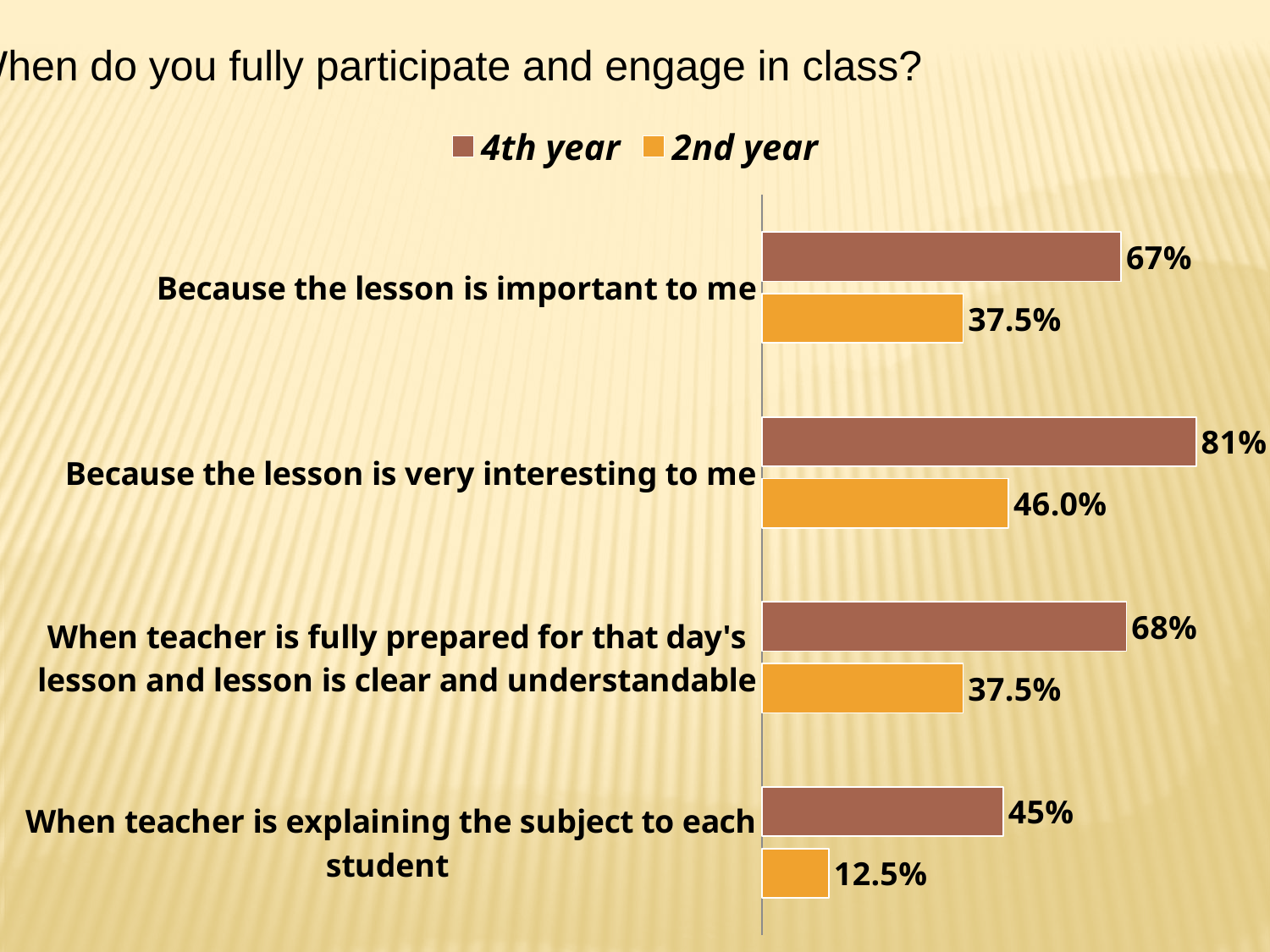
What is the 2nd year value for "When teacher is explaining the subject to each student"? 12.5% Which series is shown in orange in the legend? 2nd year How many series does the legend list? 2 What kind of chart is shown on the slide? Bar chart Which category has the lowest 2nd year value? When teacher is explaining the subject to each student What is the difference between the 4th year and 2nd year values for "Because the lesson is very interesting to me"? 35 percentage points How many categories are shown in the chart? 4 What is the 4th year value for "When teacher is fully prepared for that day's lesson and lesson is clear and understandable"? 68% Which category has the highest 4th year value? Because the lesson is very interesting to me What is the 4th year value for "Because the lesson is very interesting to me"? 81% What is the 2nd year value for "Because the lesson is important to me"? 37.5% Which is larger: the 4th year value for "Because the lesson is important to me" or the 4th year value for "When teacher is explaining the subject to each student"? Because the lesson is important to me